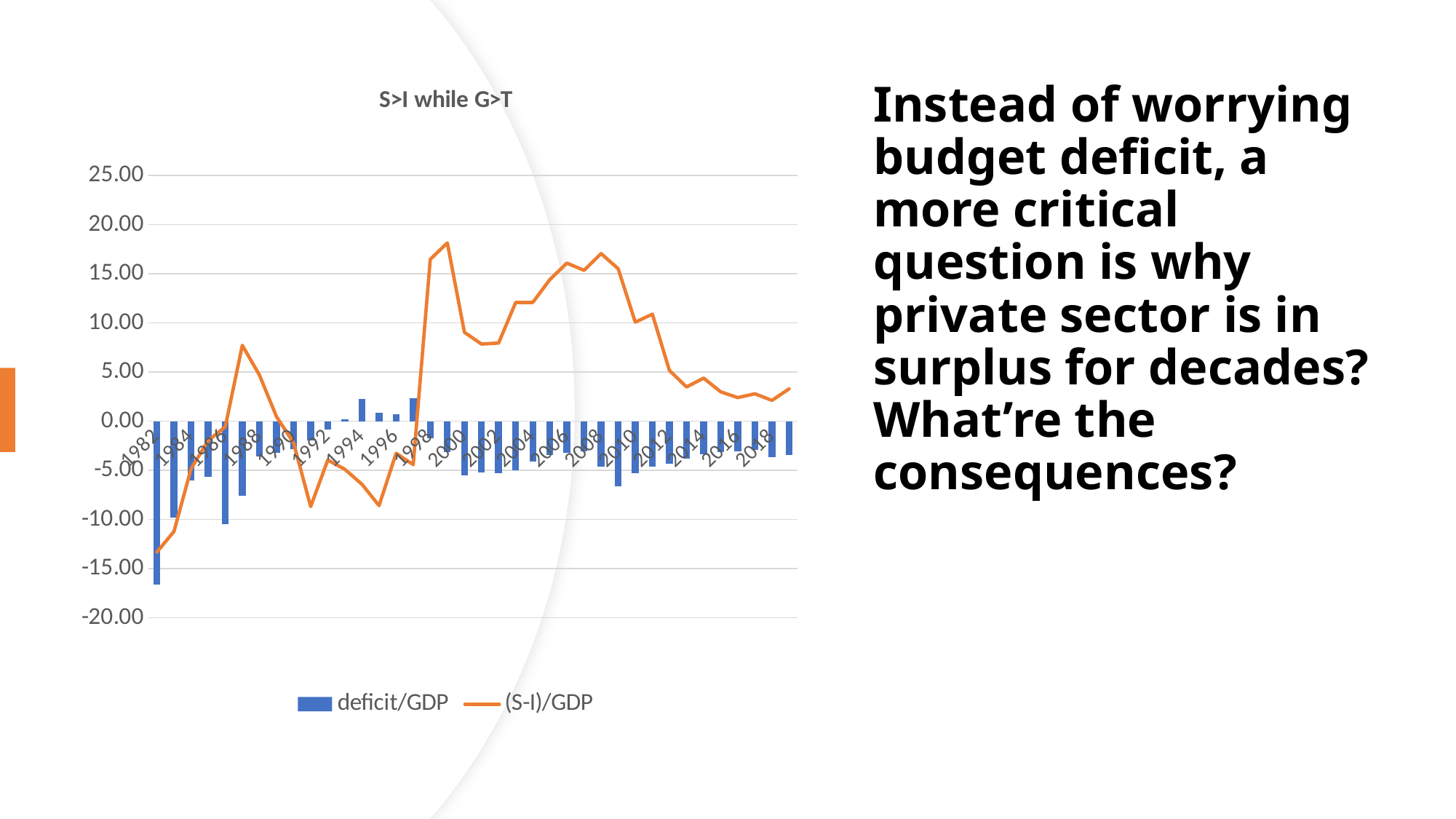
In which year does the (S-I)/GDP line reach its lowest point? 1982 What kind of chart is shown on the slide? A combined bar and line chart In which year is the deficit/GDP bar lowest? 1982 How many series does the legend list? 2 What is the title of the chart? S>I while G>T Does the (S-I)/GDP line rise or fall between 2008 and 2014? fall Which series is drawn as an orange line? (S-I)/GDP Is the (S-I)/GDP value for 2008 greater or less than 15.00? greater Which is larger, the (S-I)/GDP value in 1998 or in 2014? 1998 Is the deficit/GDP value for 1982 greater or less than -15.00? less